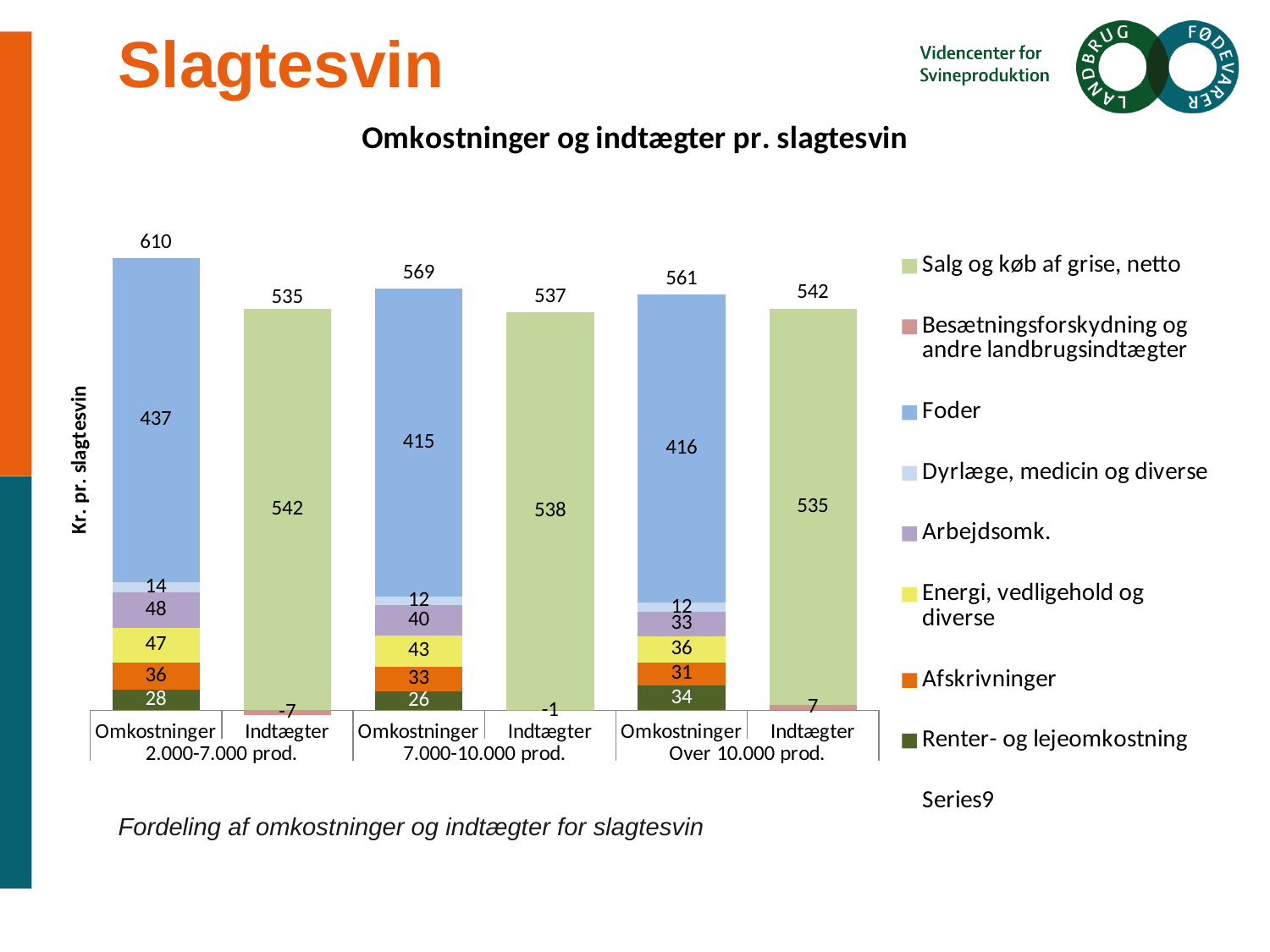
What is the Renter- og lejeomkostning value for Omkostninger in the Over 10.000 prod. group? 34 Which bar has the highest total? Omkostninger, 2.000-7.000 prod. What kind of chart is shown on the slide? Stacked bar chart Which is larger: the Foder value for Omkostninger in 2.000-7.000 prod. or in Over 10.000 prod.? 2.000-7.000 prod. What is the difference between the Omkostninger total and the Indtægter total in the 7.000-10.000 prod. group? 32 What is the Besætningsforskydning og andre landbrugsindtægter value for Indtægter in the 2.000-7.000 prod. group? -7 What is the total of the Omkostninger bar for 2.000-7.000 prod.? 610 How many entries does the legend list? 9 Which bar has the lowest total? Indtægter, 2.000-7.000 prod. What is the Salg og køb af grise, netto value for Indtægter in the Over 10.000 prod. group? 535 How many bars are plotted in the chart? 6 What is the Foder value for Omkostninger in the 7.000-10.000 prod. group? 415